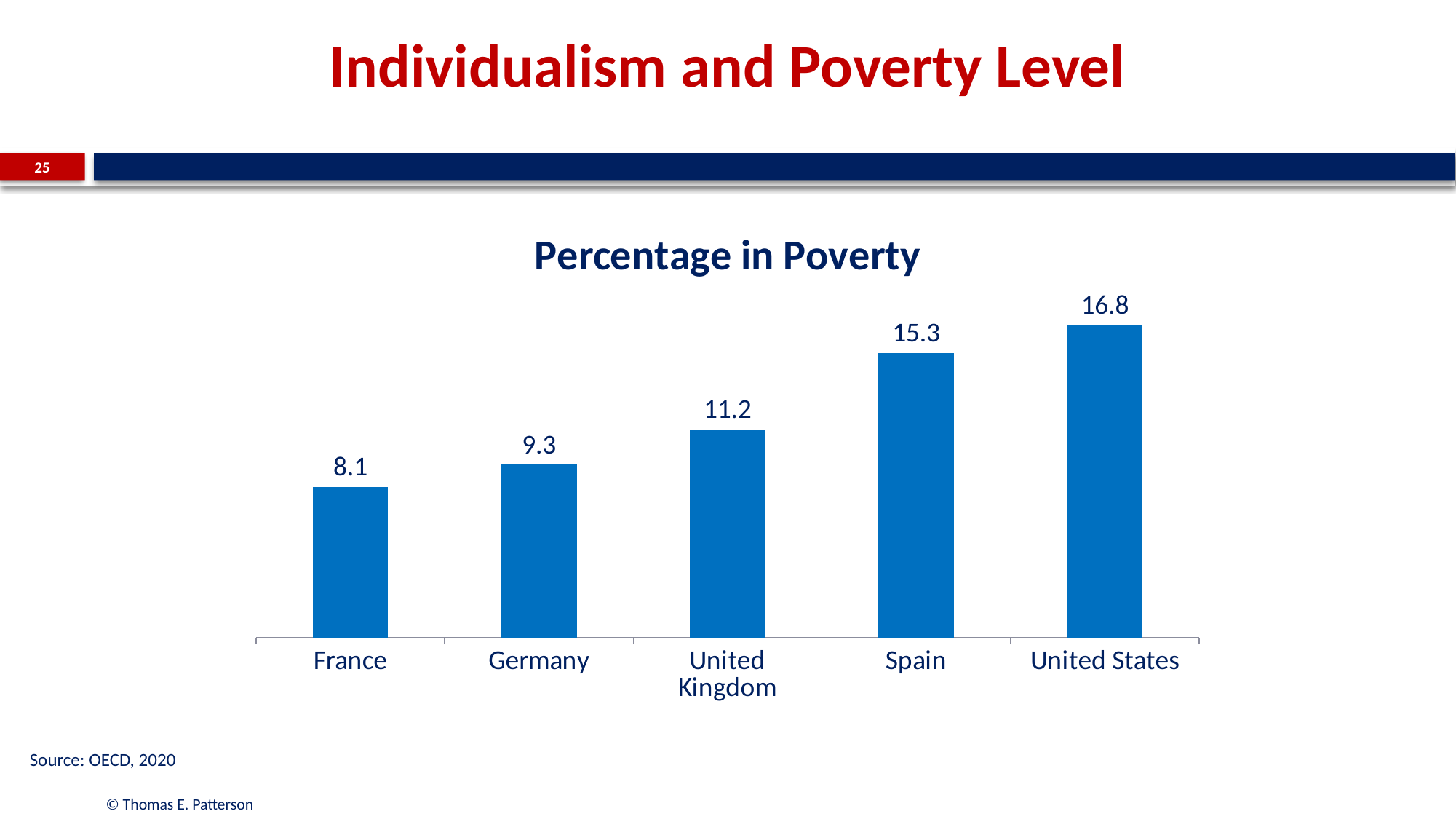
What is the difference between the percentage in poverty for Spain and the United Kingdom? 4.1 Which has a higher percentage in poverty, Germany or Spain? Spain Which country has the lowest percentage in poverty? France Which country has the highest percentage in poverty? United States What kind of chart is shown on the slide? Bar chart What is the difference between the percentage in poverty for the United States and Germany? 7.5 What is the percentage in poverty for France? 8.1 What is the percentage in poverty for the United Kingdom? 11.2 What is the percentage in poverty for Spain? 15.3 How many countries are shown in the chart? 5 Do the values rise or fall from left to right across the countries? Rise What is the title of the chart? Percentage in Poverty